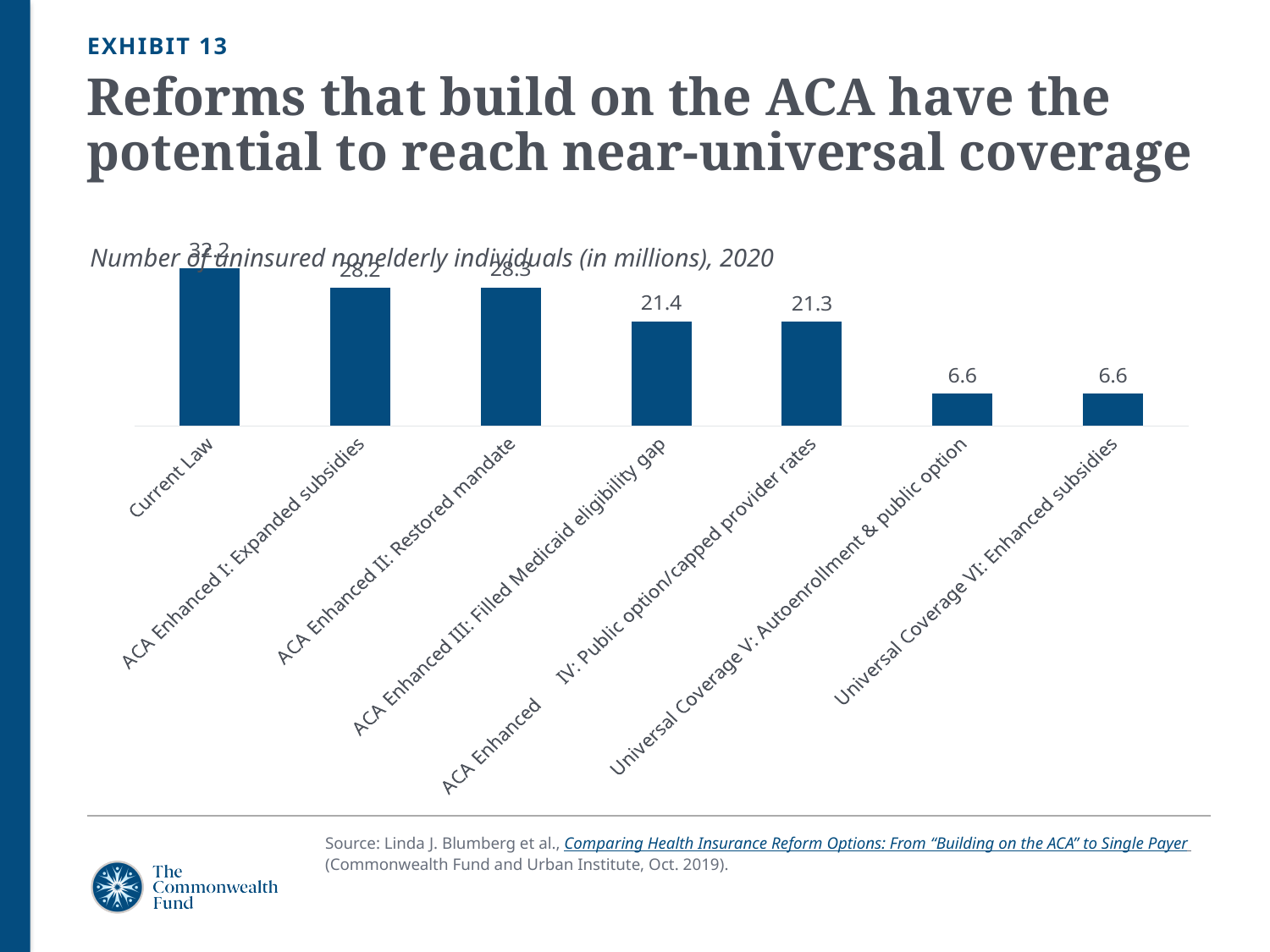
How many categories (bars) are plotted in the chart? 7 Do the values generally rise or fall moving from left to right across the chart? fall What type of chart is shown on the slide? bar chart What is the number of uninsured nonelderly individuals (in millions) under ACA Enhanced I: Expanded subsidies? 28.2 What is the value for Universal Coverage V: Autoenrollment & public option? 6.6 What is the value for ACA Enhanced III: Filled Medicaid eligibility gap? 21.4 What is the value for ACA Enhanced IV: Public option/capped provider rates? 21.3 Which is larger: the value for ACA Enhanced I: Expanded subsidies or for ACA Enhanced III: Filled Medicaid eligibility gap? ACA Enhanced I: Expanded subsidies Which category has the highest number of uninsured nonelderly individuals? Current Law What is the lowest value shown in the chart? 6.6 What is the value for Current Law? 32.2 What is the difference between the values for ACA Enhanced III: Filled Medicaid eligibility gap and Universal Coverage VI: Enhanced subsidies? 14.8